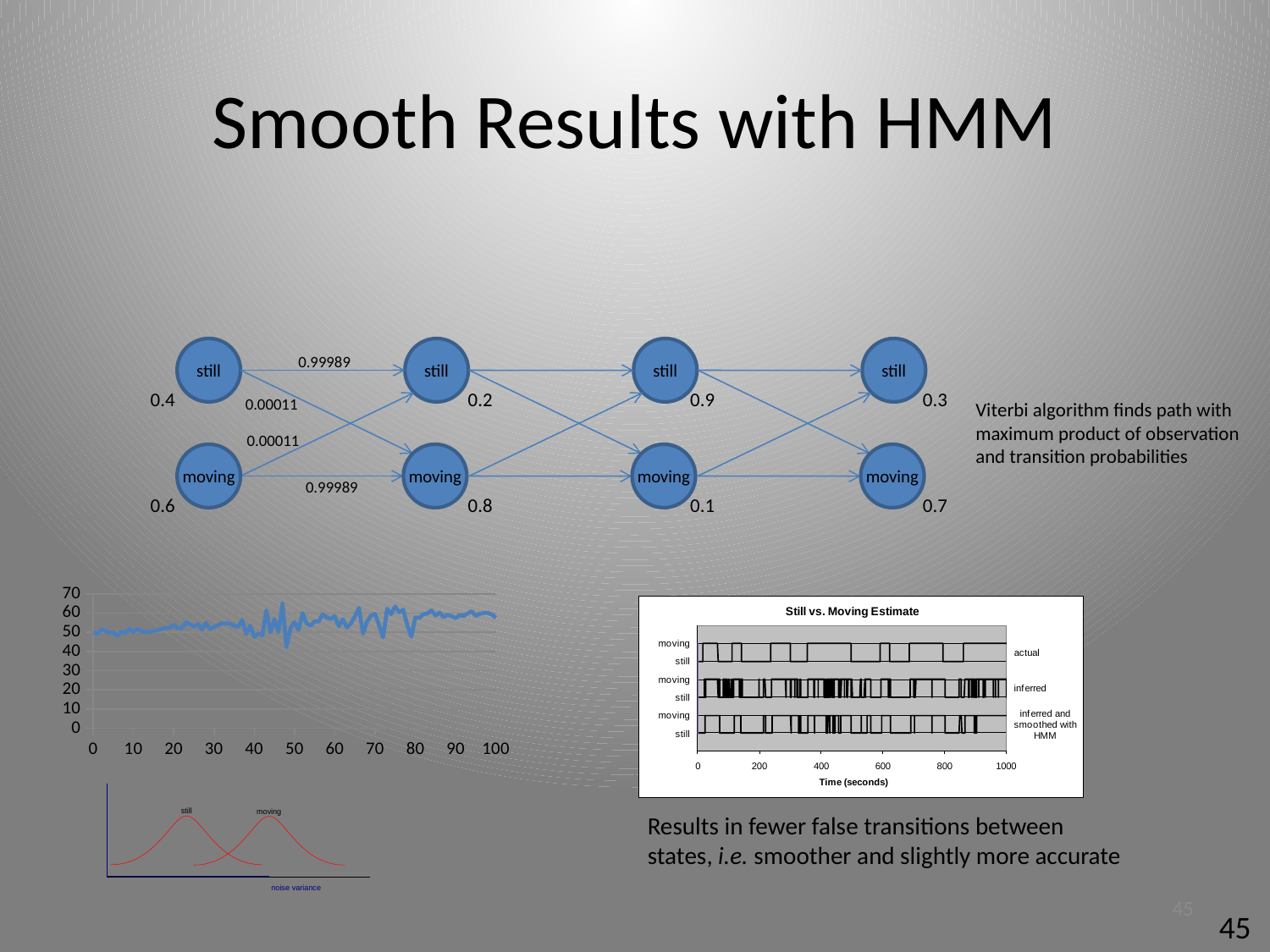
On the bottom-left line chart, what is the highest value shown on the y axis? 70 What kind of chart is the chart at the bottom left of the slide with the x axis running from 0 to 100? line chart On the bottom-left line chart, is the value at x = 10 greater or less than 40? greater How many series are plotted in the 'Still vs. Moving Estimate' chart? 3 What is the title of the chart at the bottom right of the slide? Still vs. Moving Estimate In the small chart at the bottom left with two red curves, how many curves are plotted? 2 On the bottom-left line chart, do the values generally rise or fall from x = 0 to x = 100? rise In the 'Still vs. Moving Estimate' chart, what is the label of the x axis? Time (seconds) On the bottom-left line chart, is the value at x = 90 greater or less than 70? less In the small chart with two red curves over 'noise variance', which curve peaks further to the right, 'still' or 'moving'? moving In the 'Still vs. Moving Estimate' chart, which series is labelled as smoothed? inferred and smoothed with HMM In the 'Still vs. Moving Estimate' chart, what is the largest value shown on the x axis? 1000